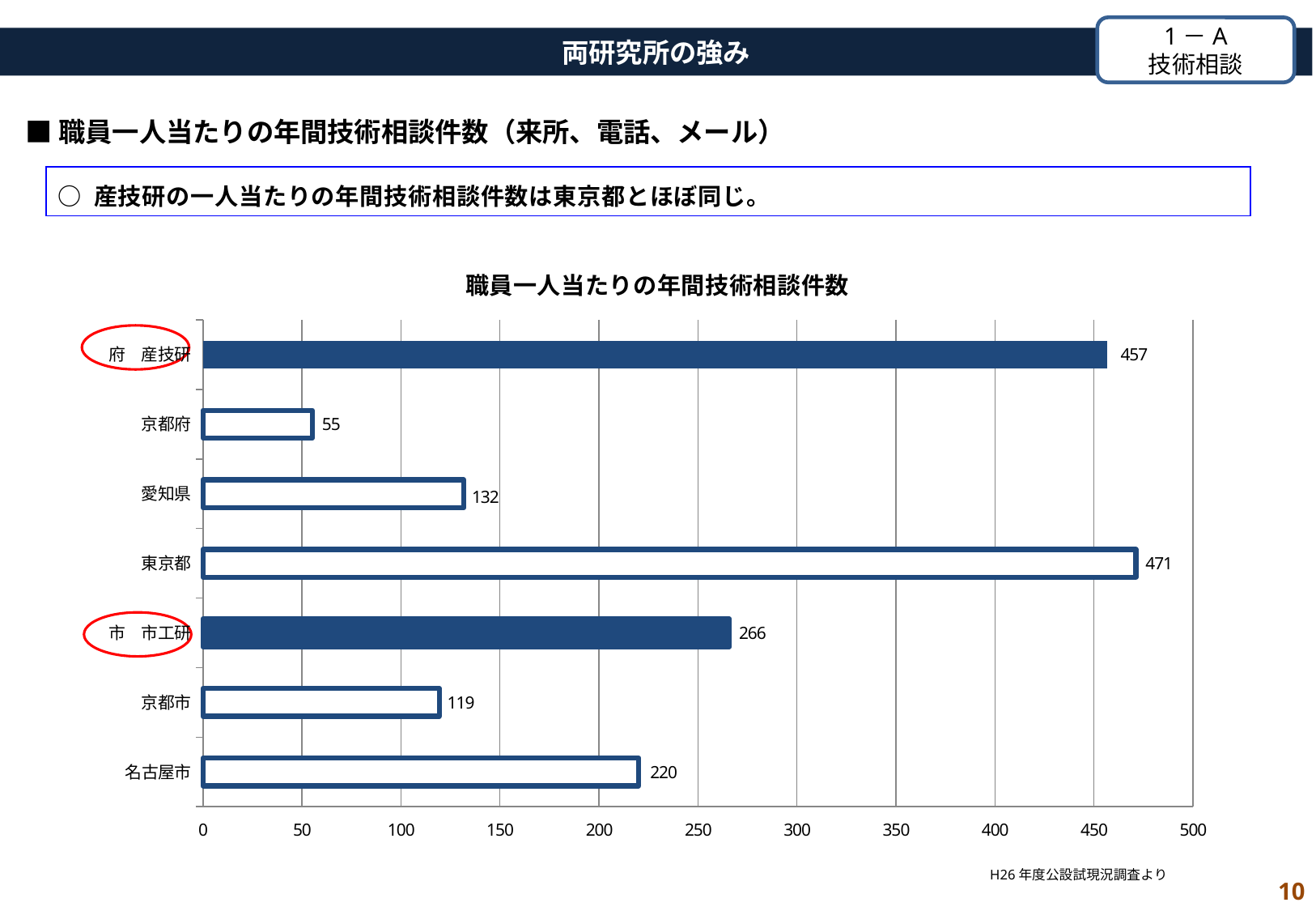
What is the value for 府 産技研 in the chart? 457 Which is larger, the value for 愛知県 or the value for 京都市? 愛知県 How many categories are shown in the chart? 7 Which category has the lowest value in the chart? 京都府 What is the difference between the values for 東京都 and 府 産技研? 14 What is the title of the chart? 職員一人当たりの年間技術相談件数 What is the value for 東京都 in the chart? 471 What is the difference between the values for 市 市工研 and 京都市? 147 What is the value for 名古屋市 in the chart? 220 What is the value for 市 市工研 in the chart? 266 Which category has the highest value in the chart? 東京都 What kind of chart is shown on the slide? bar chart